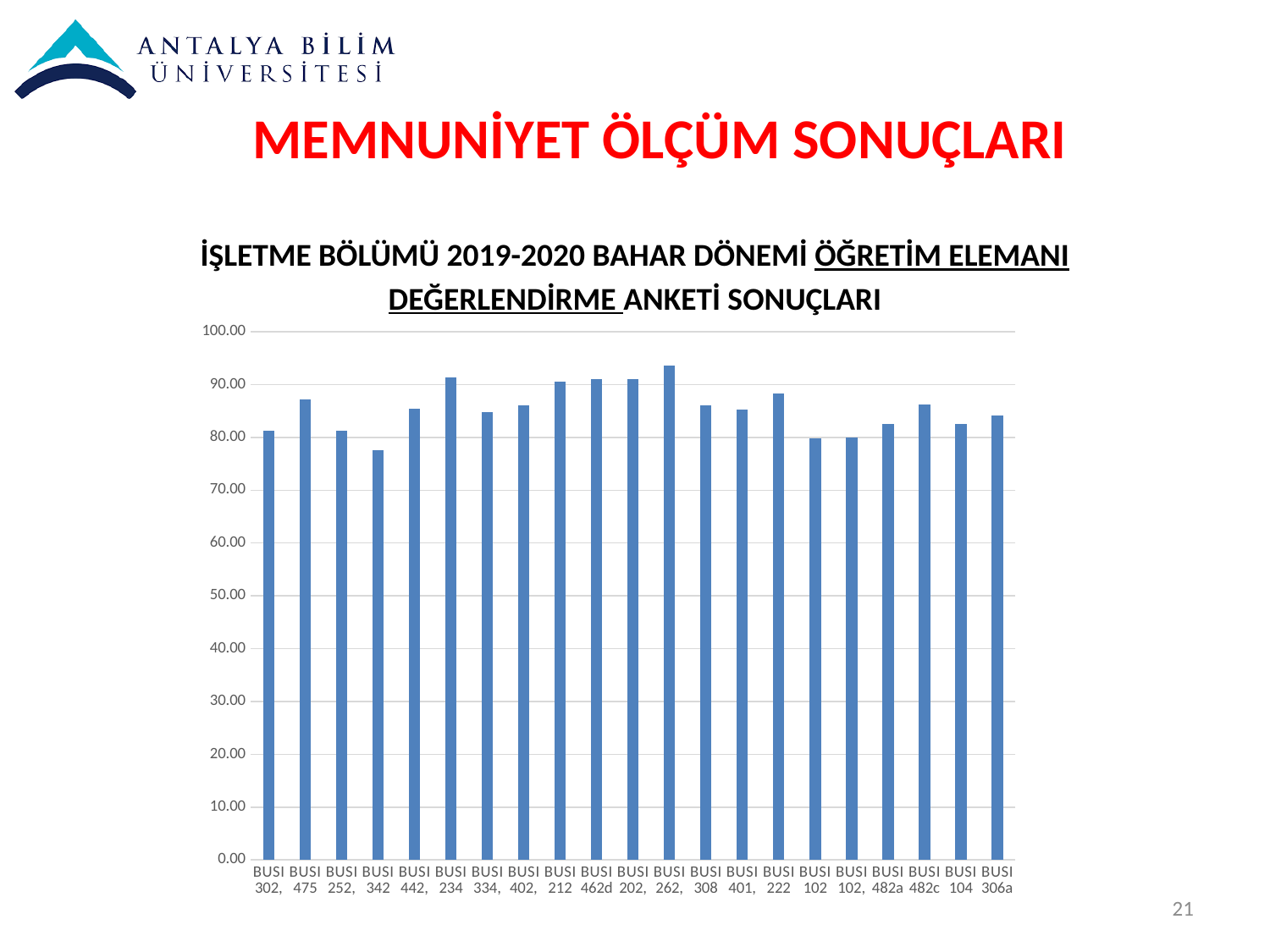
What is the highest value shown on the vertical axis of the chart? 100.00 Which department and semester does the chart title say the survey results are for? İşletme Bölümü 2019-2020 Bahar Dönemi Which course has the lowest value in the chart? BUSI 342 Is the value for BUSI 234 greater or less than 90.00? greater Is the value for BUSI 222 greater or less than 90.00? less Is the value for BUSI 342 greater or less than 80.00? less How many courses (bars) are plotted in the chart? 21 What kind of chart is shown on the slide? bar chart Which course has the highest value in the chart? BUSI 262 Which has the larger value, BUSI 234 or BUSI 334? BUSI 234 Which has the larger value, BUSI 475 or BUSI 342? BUSI 475